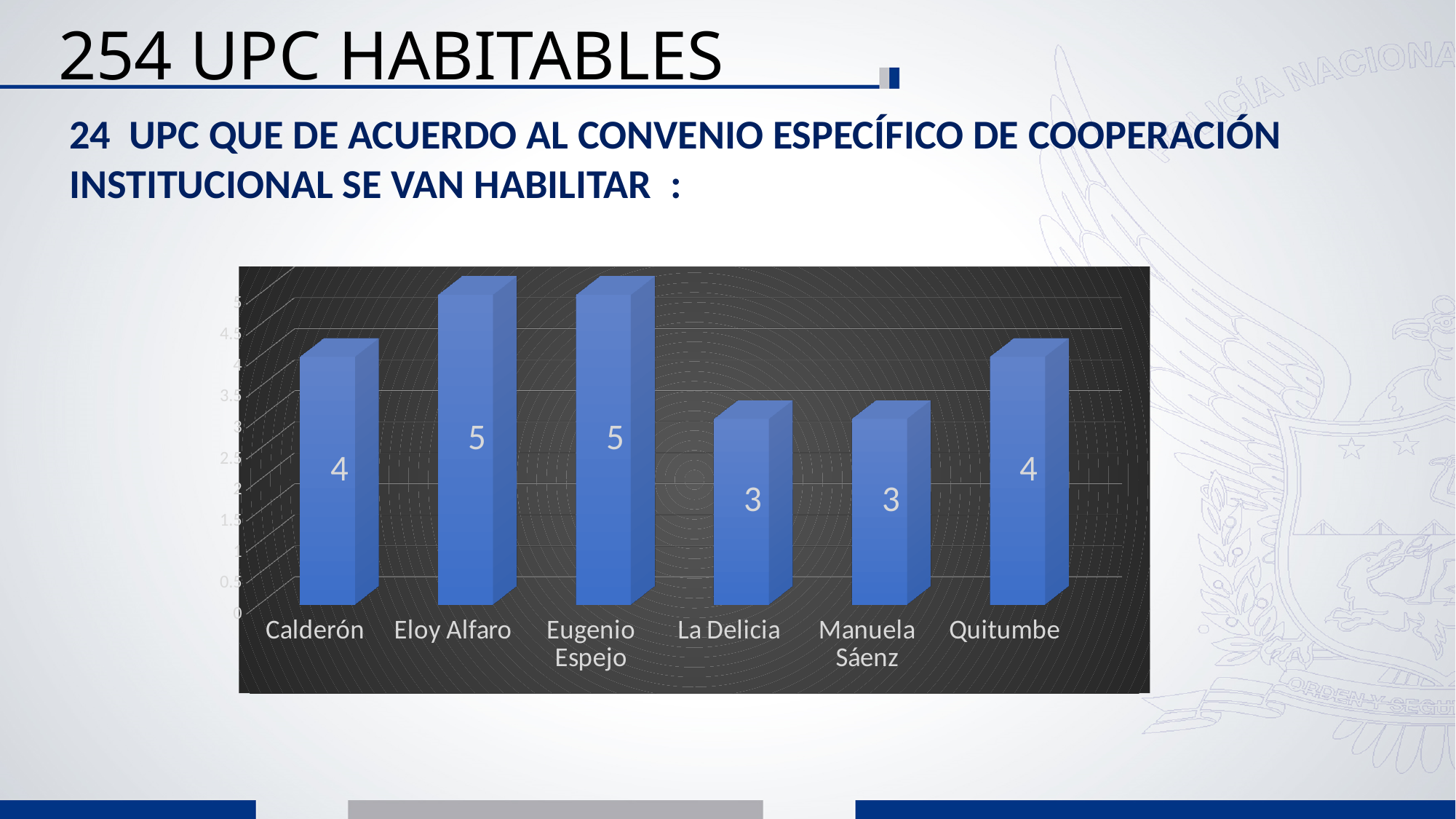
What is the value for Calderón? 4 Which categories have the highest value? Eloy Alfaro and Eugenio Espejo What kind of chart is shown on the slide? Bar chart Which categories have the lowest value? La Delicia and Manuela Sáenz What is the total of all the values shown in the chart? 24 What is the value for La Delicia? 3 Which is larger, the value for Calderón or the value for Manuela Sáenz? Calderón What is the difference between the values for Eugenio Espejo and La Delicia? 2 How many categories are shown on the x axis? 6 What is the value for Manuela Sáenz? 3 What is the value for Eloy Alfaro? 5 What is the value for Quitumbe? 4